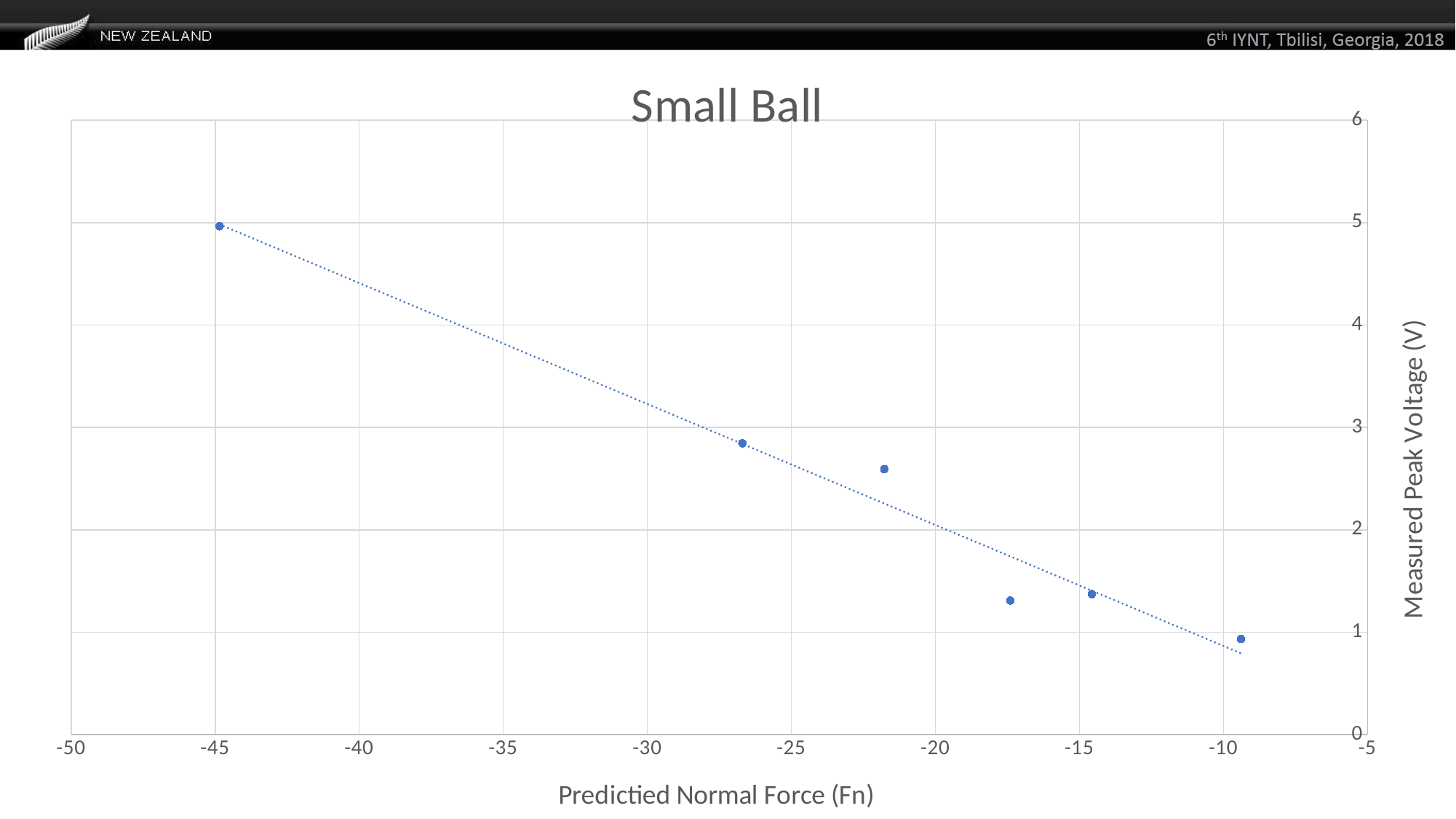
How many data points are plotted on the chart? 6 What is the label of the vertical axis? Measured Peak Voltage (V) Which point has the highest measured peak voltage: the one at a predicted normal force of about -45 or the one at about -10? the one at about -45 Is the measured peak voltage for the point at a predicted normal force of about -45 greater or less than 4? greater Is the measured peak voltage for the point at a predicted normal force of about -22 greater or less than 3? less Is the measured peak voltage for the point at a predicted normal force of about -17 greater or less than 2? less What kind of chart is shown on the slide? scatter chart Do the measured peak voltage values rise or fall as the predicted normal force increases from -50 toward -5 along the x axis? fall What is the title of the chart? Small Ball